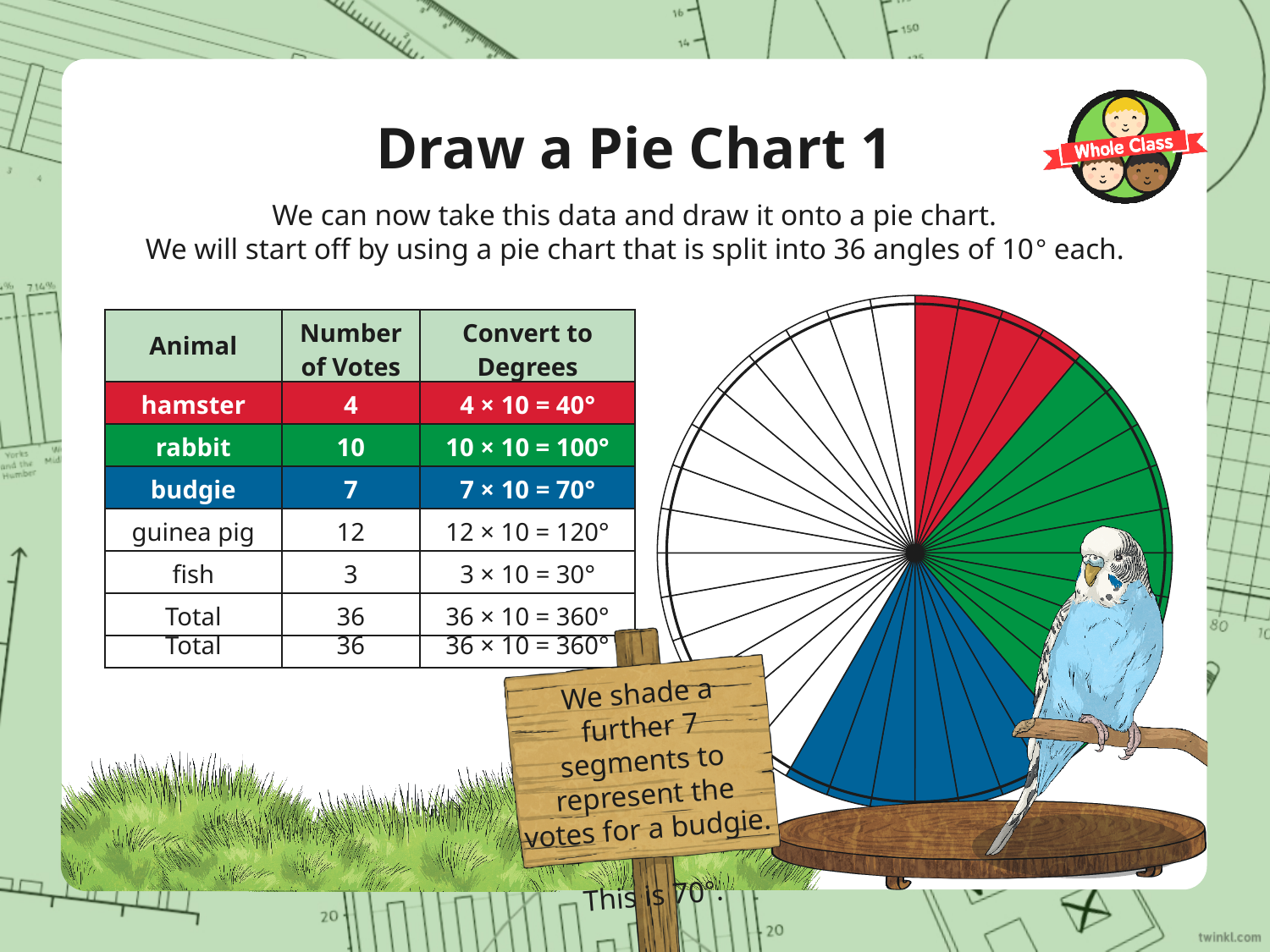
How many more votes did the rabbit get than the budgie? 3 What colour is used for the budgie segments on the pie chart? blue Which got more votes, the hamster or the budgie? budgie How many votes did the hamster receive? 4 How many degrees is each segment of the pie chart? 10° Which animal received the most votes? guinea pig Which animal received the fewest votes? fish What kind of chart is shown on the slide? pie chart What is the total number of votes in the table? 36 How many equal angles is the pie chart split into? 36 How many degrees does the budgie slice of the pie chart represent? 70° How many degrees does the rabbit slice of the pie chart represent? 100°